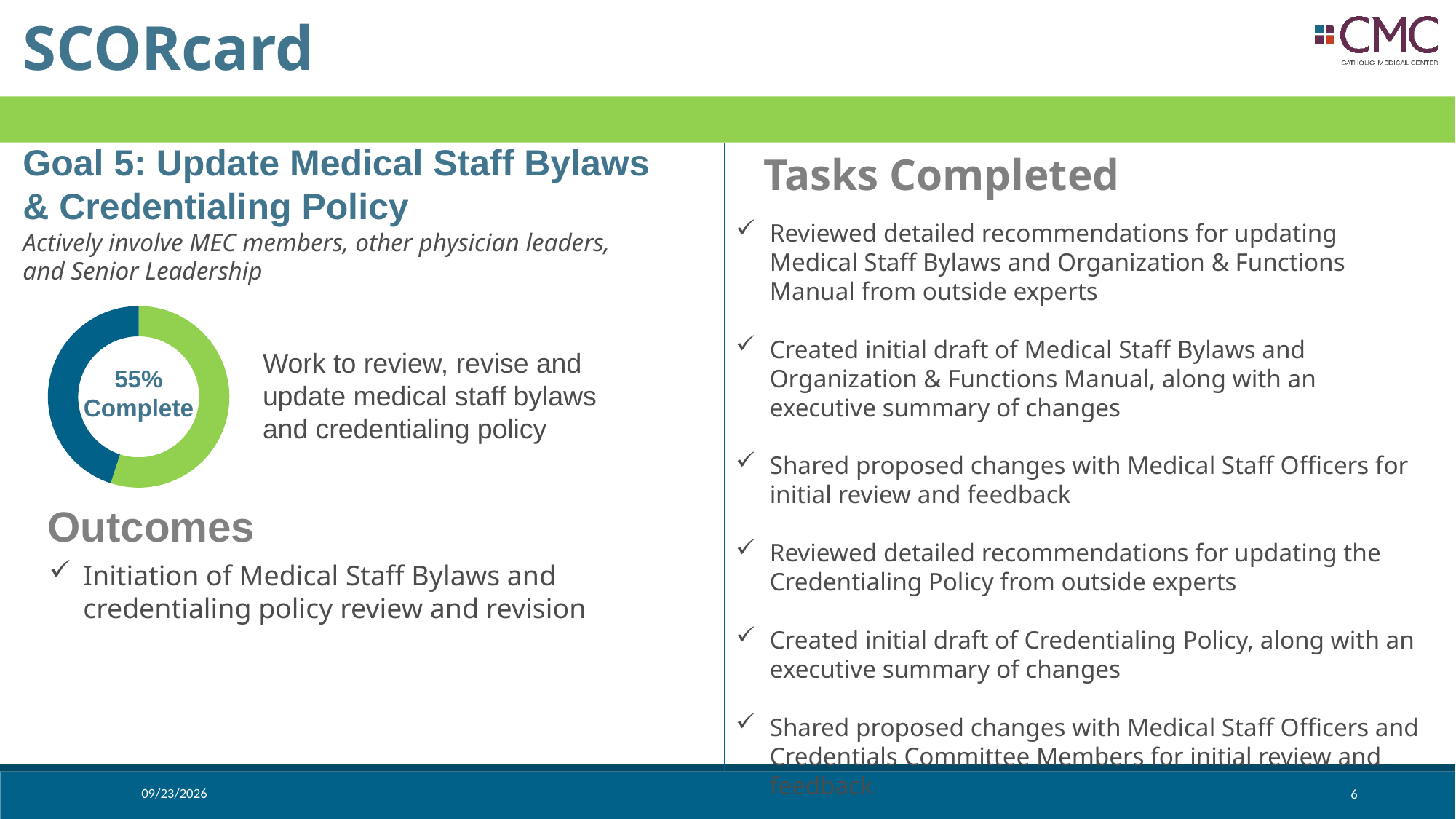
What percentage complete does the donut chart show for Goal 5? 55% Is the completed share shown in the donut chart greater or less than 50%? greater What share of the donut chart does the green (completed) portion represent? 55% What colour is used for the completed portion of the donut chart? Green What share of the donut chart does the dark blue (remaining) portion represent? 45% What text is printed in the centre of the donut chart? 55% Complete What kind of chart is shown on the left of the slide under the Goal 5 heading? Donut (pie) chart Which segment of the donut chart is larger, the green one or the dark blue one? Green Does the donut chart include a legend? No How many segments does the donut chart have? 2